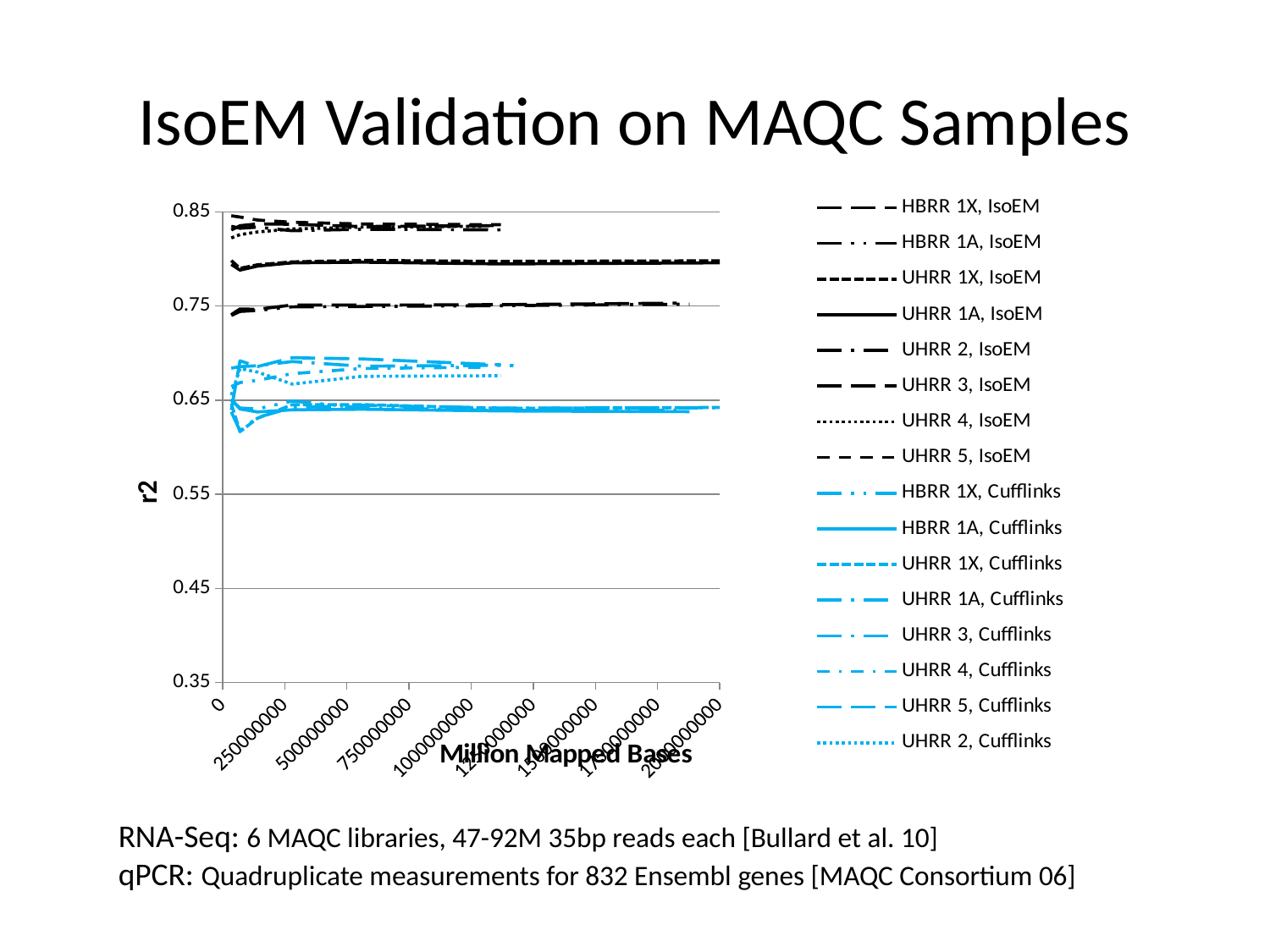
Are the IsoEM series lines greater or less than 0.65 on the r2 axis? greater Is the value for UHRR 1A, IsoEM (the solid black line) greater or less than 0.75? greater What is the highest value shown on the y axis of the chart? 0.85 Are the Cufflinks series lines greater or less than 0.75 on the r2 axis? less What is the label on the x axis of the chart? Million Mapped Bases Which series has higher r2 values: UHRR 1A, IsoEM (solid black line) or HBRR 1A, Cufflinks (solid blue line)? UHRR 1A, IsoEM What is the label on the y axis of the chart? r2 How many series does the chart legend list? 16 What kind of chart is shown on the slide? line chart